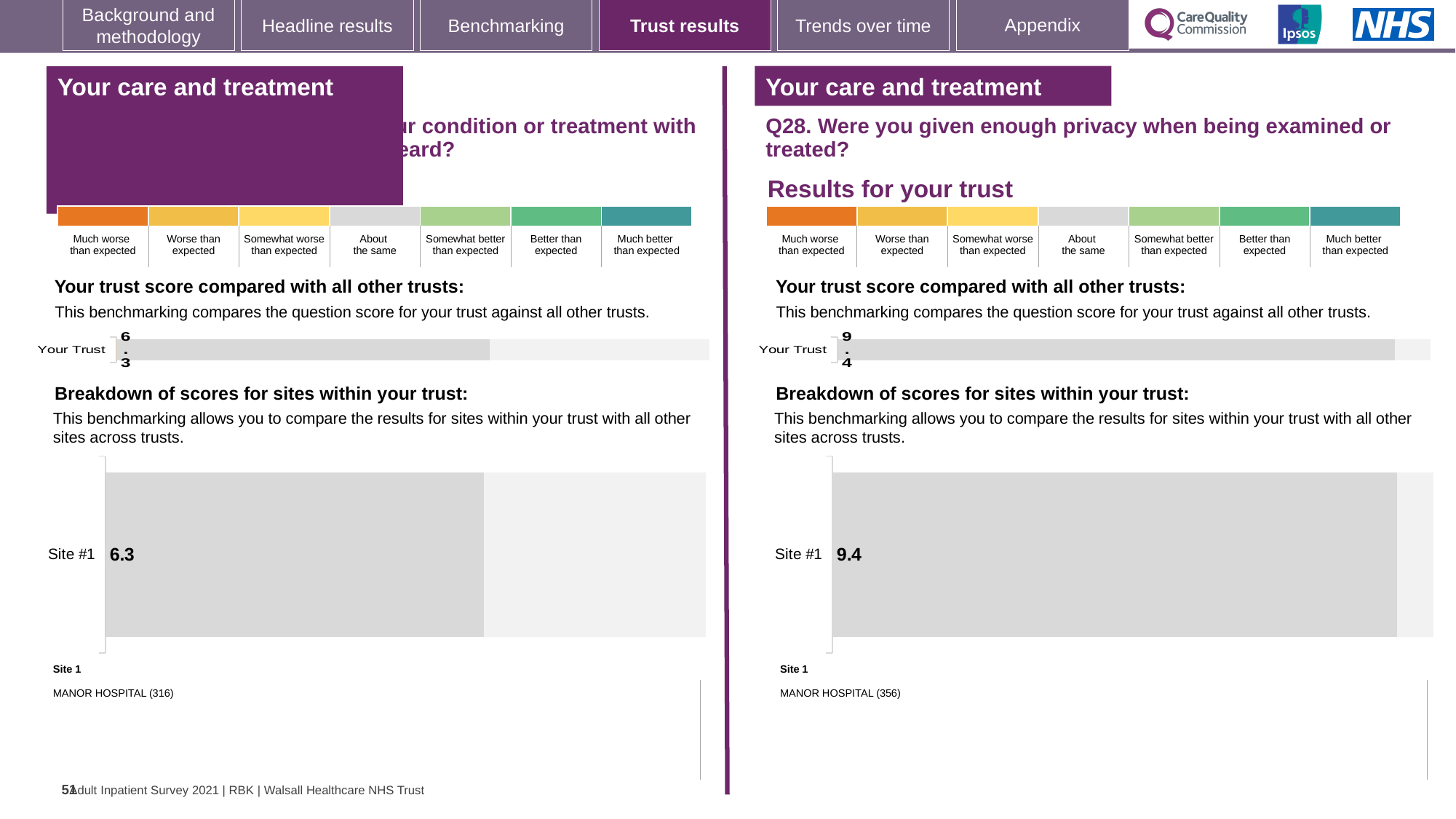
On the right-hand panel (Q28), what score is shown for Site #1 in the 'Breakdown of scores for sites within your trust' chart? 9.4 On the left-hand panel, what is the score shown for Your Trust in the 'Your trust score compared with all other trusts' chart? 6.3 On the left-hand panel, what score is shown for Site #1 in the 'Breakdown of scores for sites within your trust' chart? 6.3 How many sites are shown in the 'Breakdown of scores for sites within your trust' chart on the right-hand panel (Q28)? 1 On the right-hand panel (Q28), what is the score shown for Your Trust in the 'Your trust score compared with all other trusts' chart? 9.4 What is the difference between the Site #1 score on the right-hand panel (Q28) and the Site #1 score on the left-hand panel? 3.1 What type of chart is used to show the Site #1 score on the left-hand panel? Bar chart On the right-hand panel (Q28), which site is listed as Site 1 below the breakdown chart? MANOR HOSPITAL (356) On the left-hand panel, which site is listed as Site 1 below the breakdown chart? MANOR HOSPITAL (316) On the left-hand panel, is the Your Trust score greater or less than 7? less On the right-hand panel (Q28), is the Site #1 score greater or less than 9? greater Which is larger: the Site #1 score on the left-hand panel or the Site #1 score on the right-hand panel (Q28)? Right-hand panel (Q28)